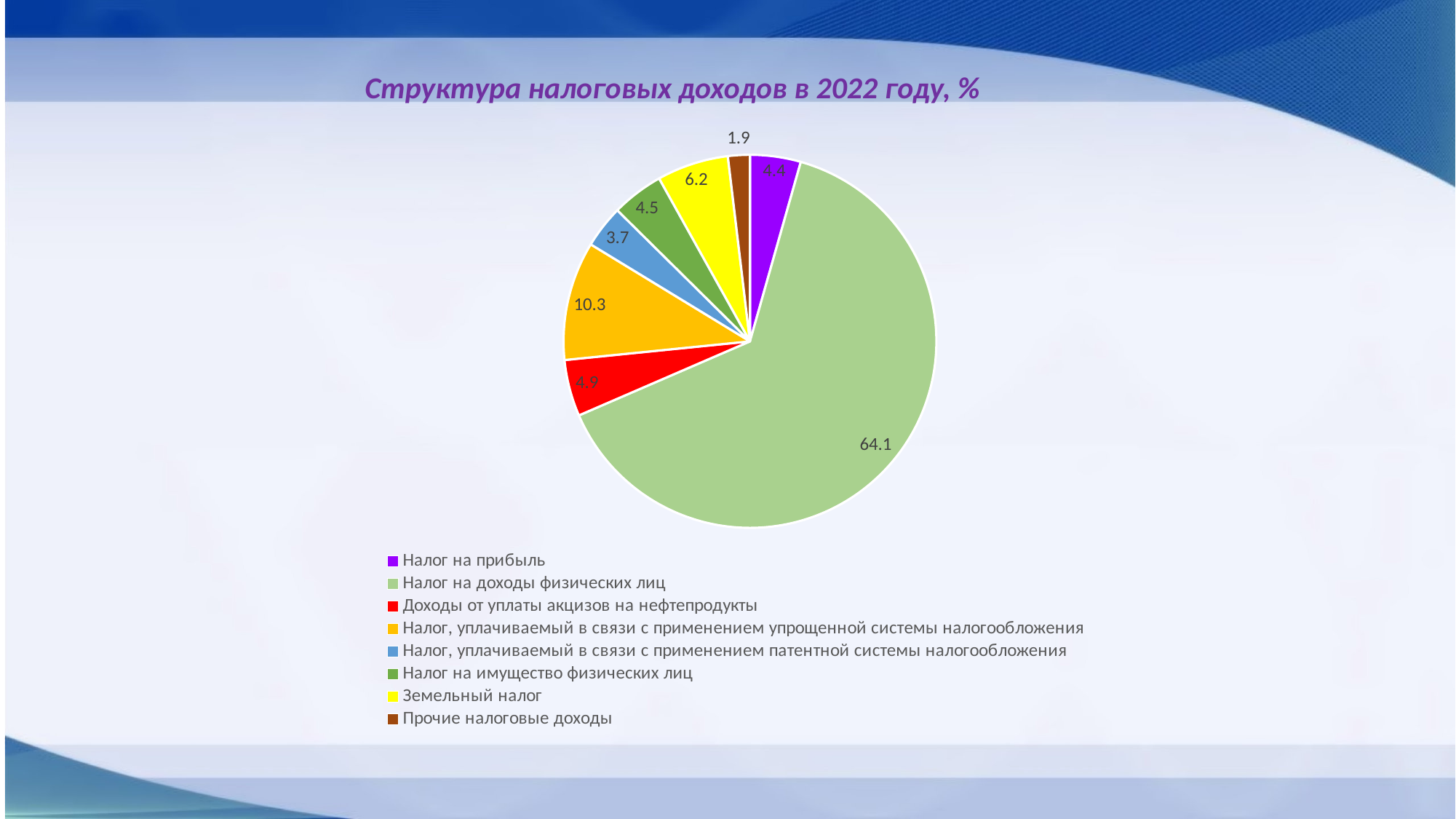
Which category has the largest share of the pie? Налог на доходы физических лиц Which category has the smallest share of the pie? Прочие налоговые доходы What is the value for Налог на доходы физических лиц? 64.1 What is the value for Земельный налог? 6.2 How many categories does the pie chart have? 8 What colour is the slice for Налог на прибыль? Purple Which is larger: Земельный налог or Доходы от уплаты акцизов на нефтепродукты? Земельный налог What is the difference between the values for Налог на доходы физических лиц and Налог, уплачиваемый в связи с применением упрощенной системы налогообложения? 53.8 What is the value for Налог, уплачиваемый в связи с применением упрощенной системы налогообложения? 10.3 What type of chart is shown on the slide? Pie chart What is the value for Прочие налоговые доходы? 1.9 What is the title of the chart? Структура налоговых доходов в 2022 году, %